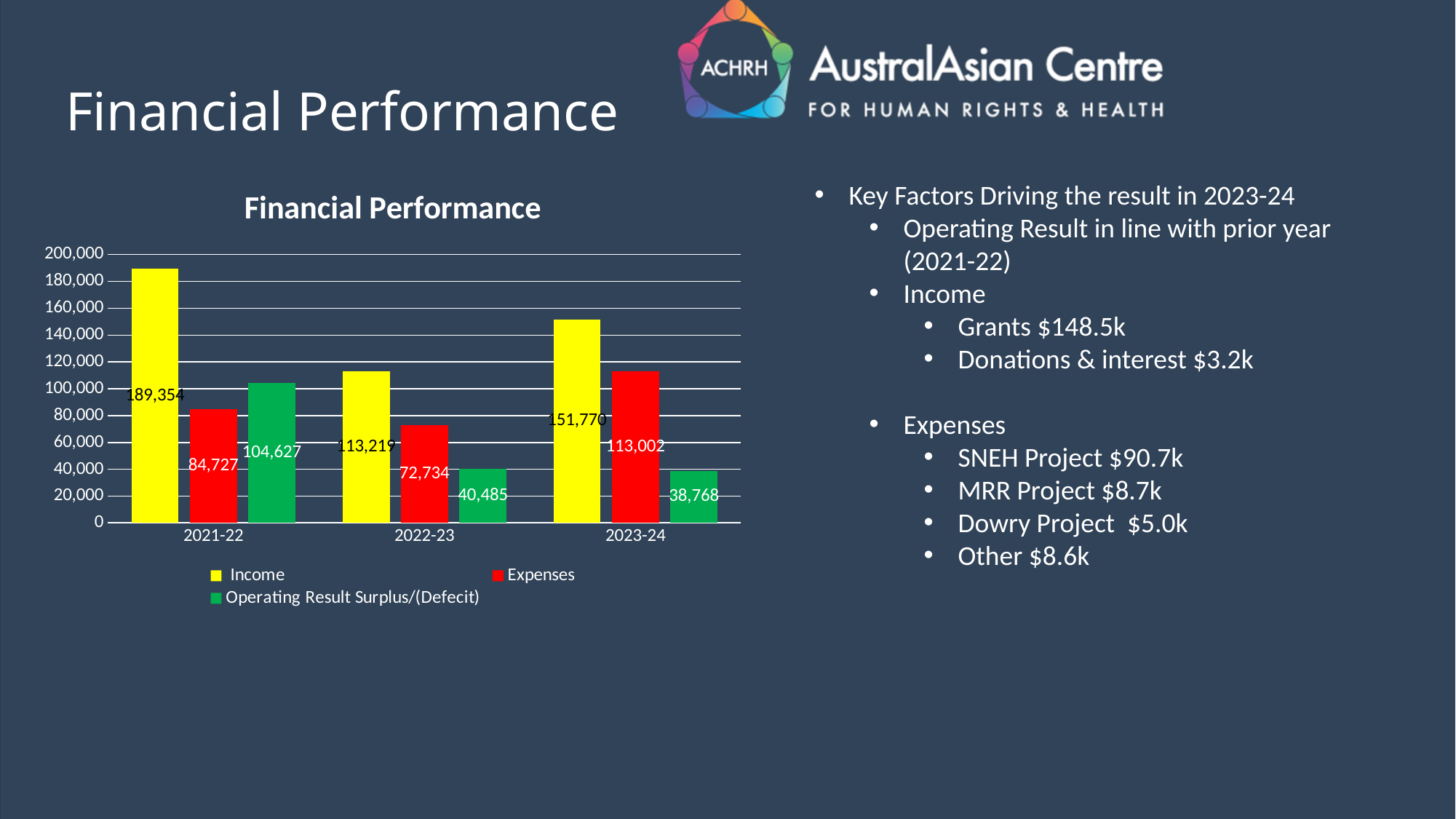
Which year has the highest Income? 2021-22 What is the Income value for 2021-22? 189,354 What is the difference between Income and Expenses in 2023-24? 38,768 What is the Expenses value for 2023-24? 113,002 Which colour represents Expenses in the chart? Red Which is larger in 2021-22: Expenses or Operating Result Surplus/(Defecit)? Operating Result Surplus/(Defecit) Which year has the lowest Expenses? 2022-23 What kind of chart is shown? Bar chart How many series does the legend list? 3 How many years are shown on the x axis? 3 What is the Operating Result Surplus/(Defecit) value for 2022-23? 40,485 Is the Income value for 2022-23 greater or less than 100,000? greater